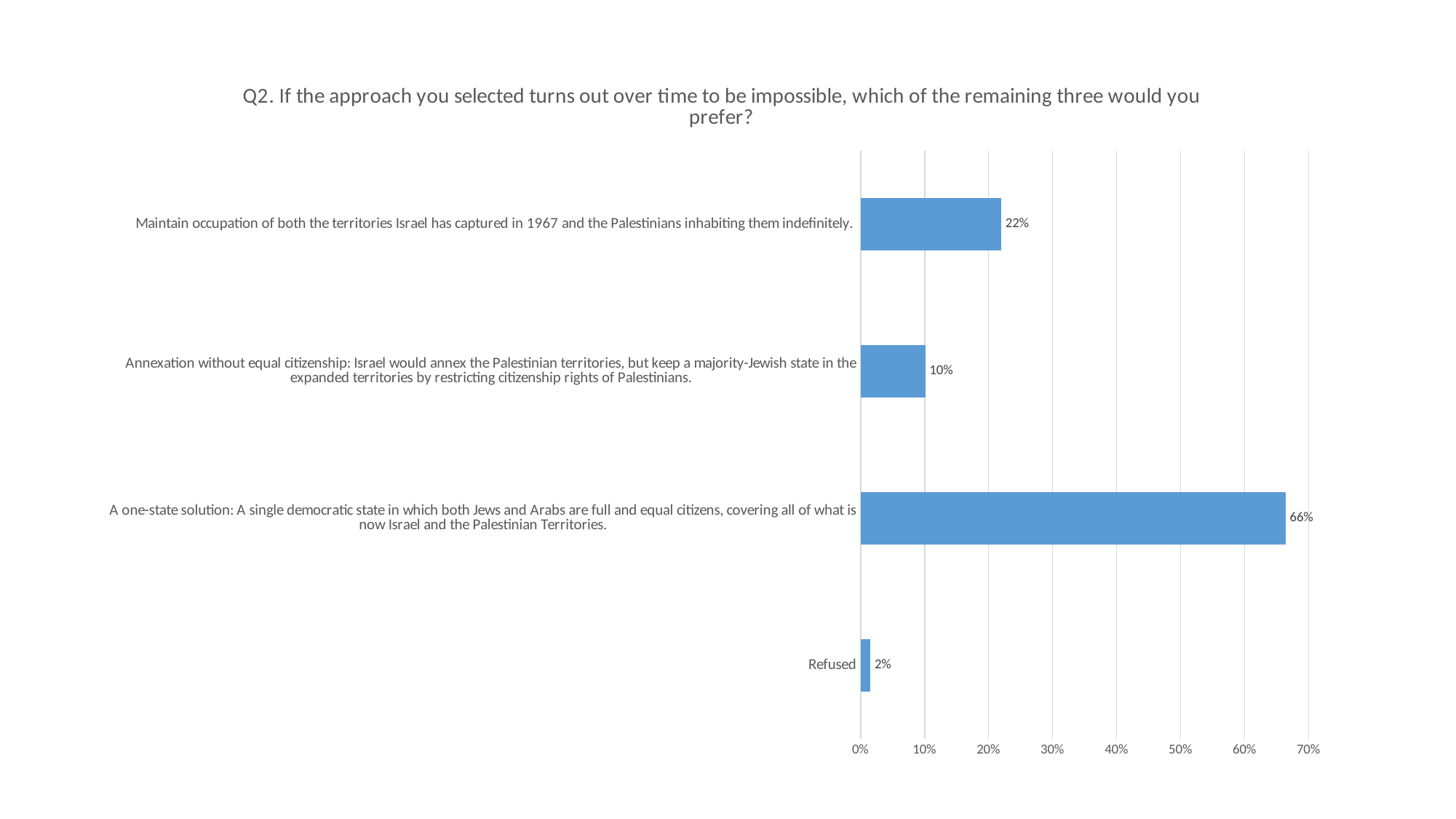
What is the difference in percentage points between the one-state solution and maintaining occupation? 44 Which option received the highest percentage of responses? A one-state solution What percentage of respondents chose to maintain occupation of the territories captured in 1967 indefinitely? 22% What percentage of respondents chose the one-state solution option? 66% What percentage of respondents chose annexation without equal citizenship? 10% What is the maximum value shown on the horizontal axis? 70% What type of chart is shown on the slide? Bar chart Which received a larger share: maintaining occupation or annexation without equal citizenship? Maintaining occupation What is the difference in percentage points between maintaining occupation and annexation without equal citizenship? 12 Which category has the lowest percentage? Refused What percentage of respondents refused to answer? 2% How many categories are shown in the chart? 4